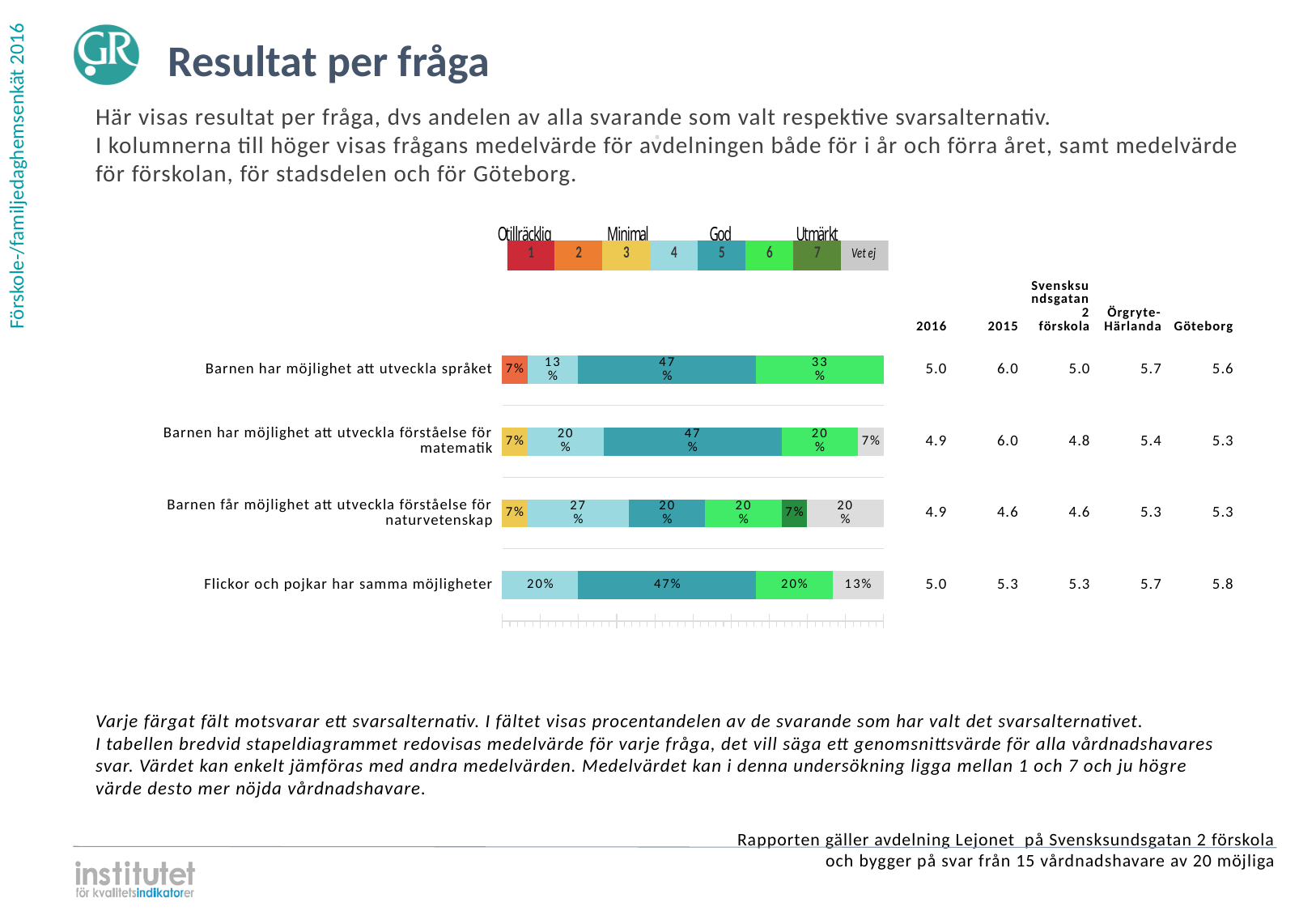
What is the 2016 mean value for 'Barnen har möjlighet att utveckla förståelse för matematik'? 4.9 What percentage of respondents chose rating 5 (God) for 'Barnen har möjlighet att utveckla språket'? 47% What kind of chart is used to show the results per question? Stacked bar chart What share of respondents answered 'Vet ej' for 'Flickor och pojkar har samma möjligheter'? 13% What percentage of respondents chose rating 6 for 'Barnen har möjlighet att utveckla språket'? 33% What share of respondents answered 'Vet ej' for 'Barnen får möjlighet att utveckla förståelse för naturvetenskap'? 20% What is the difference between the rating 5 share and the rating 6 share for 'Barnen har möjlighet att utveckla förståelse för matematik'? 27 percentage points How many questions (categories) are shown as bars in the chart? 4 What percentage of respondents chose rating 4 for 'Barnen får möjlighet att utveckla förståelse för naturvetenskap'? 27% Which is larger for 'Barnen får möjlighet att utveckla förståelse för naturvetenskap': the share for rating 4 or the share for rating 5? Rating 4 (27%) How many rating categories, including 'Vet ej', does the legend above the chart show? 8 Which rating segment is the largest in the bar for 'Flickor och pojkar har samma möjligheter'? 5 (God), 47%